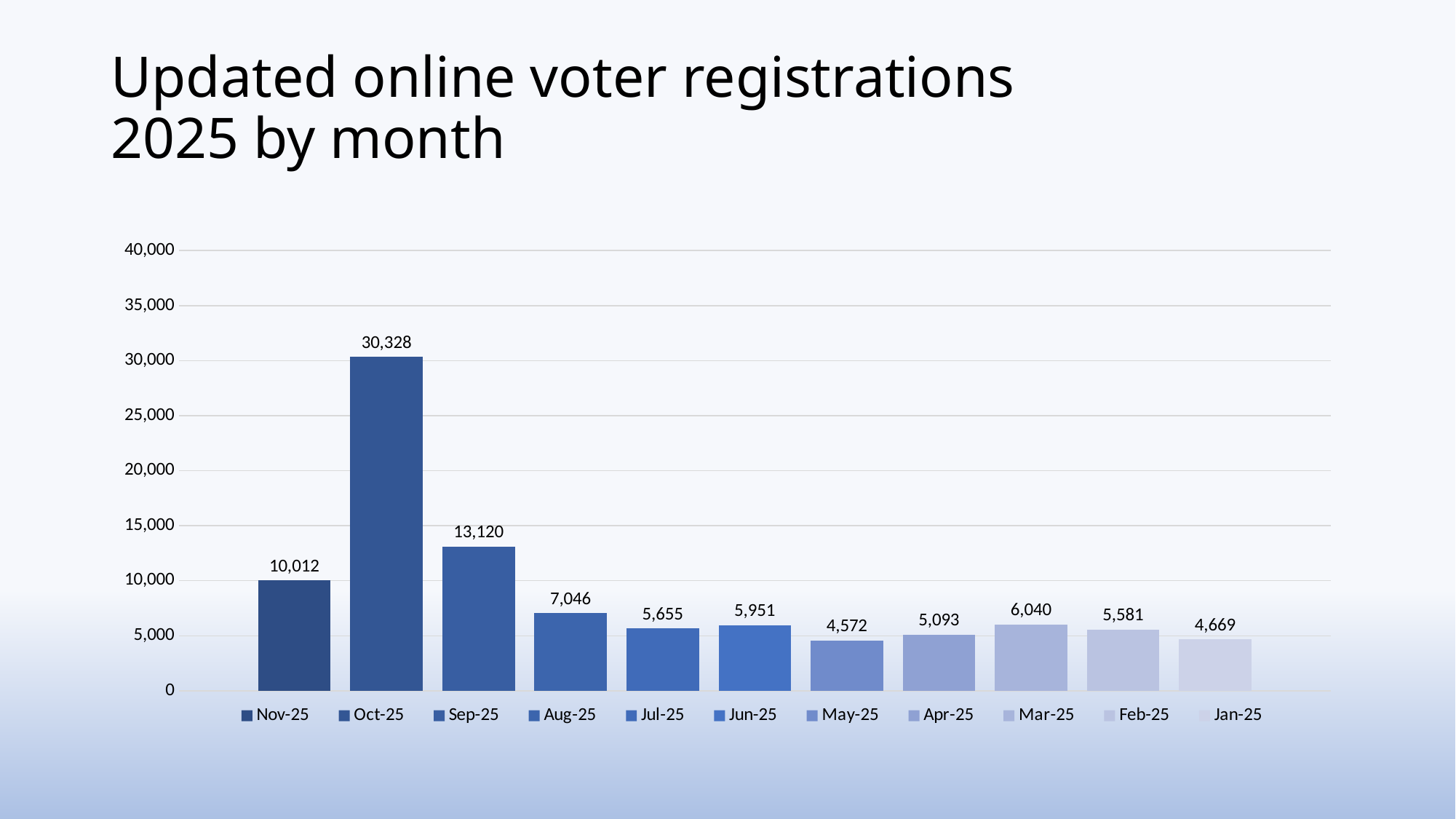
Is the value for Sep-25 greater or less than 10,000? greater What is the value for May-25? 4,572 Which month has the highest value? Oct-25 What is the difference between the values for Oct-25 and Sep-25? 17,208 What kind of chart is shown on the slide? bar chart How many months are shown in the chart? 11 What is the value for Oct-25? 30,328 Which is larger, the value for Mar-25 or the value for Feb-25? Mar-25 How many entries does the legend list? 11 What is the title of the slide? Updated online voter registrations 2025 by month Which month has the lowest value? May-25 What is the value for Nov-25? 10,012